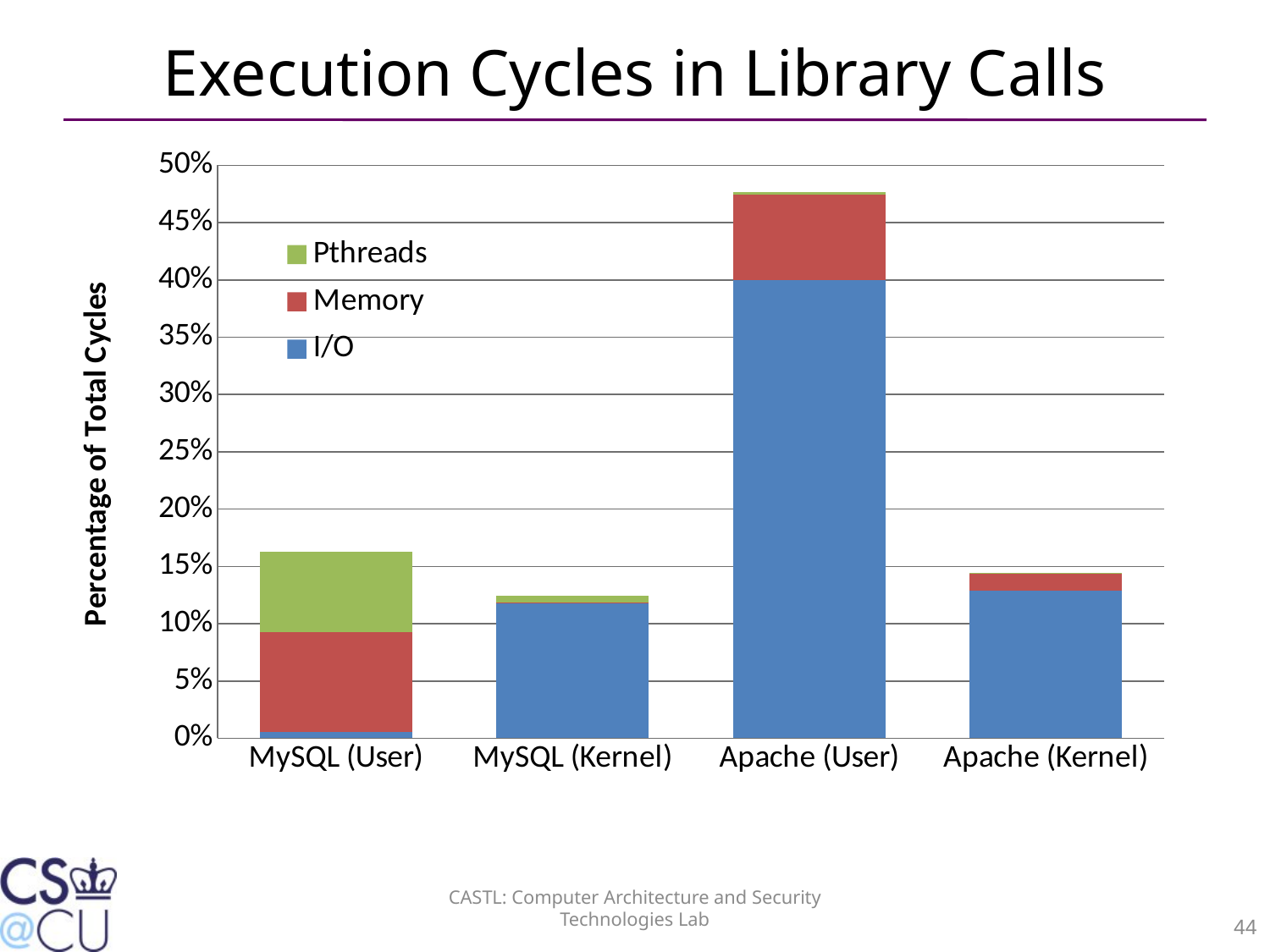
Which series is shown in green in the legend? Pthreads Which has a larger total, Apache (Kernel) or MySQL (Kernel)? Apache (Kernel) Is the total value for MySQL (Kernel) greater or less than 10%? greater What kind of chart is shown on the slide? stacked bar chart Which has a larger total, Apache (User) or MySQL (User)? Apache (User) Is the total value for Apache (User) greater or less than 45%? greater How many series does the legend list? 3 How many categories are shown on the x axis? 4 Which category has the lowest total percentage of cycles? MySQL (Kernel) Is the total value for MySQL (User) greater or less than 20%? less Which category has the highest total percentage of cycles? Apache (User) What is the title of the chart? Execution Cycles in Library Calls